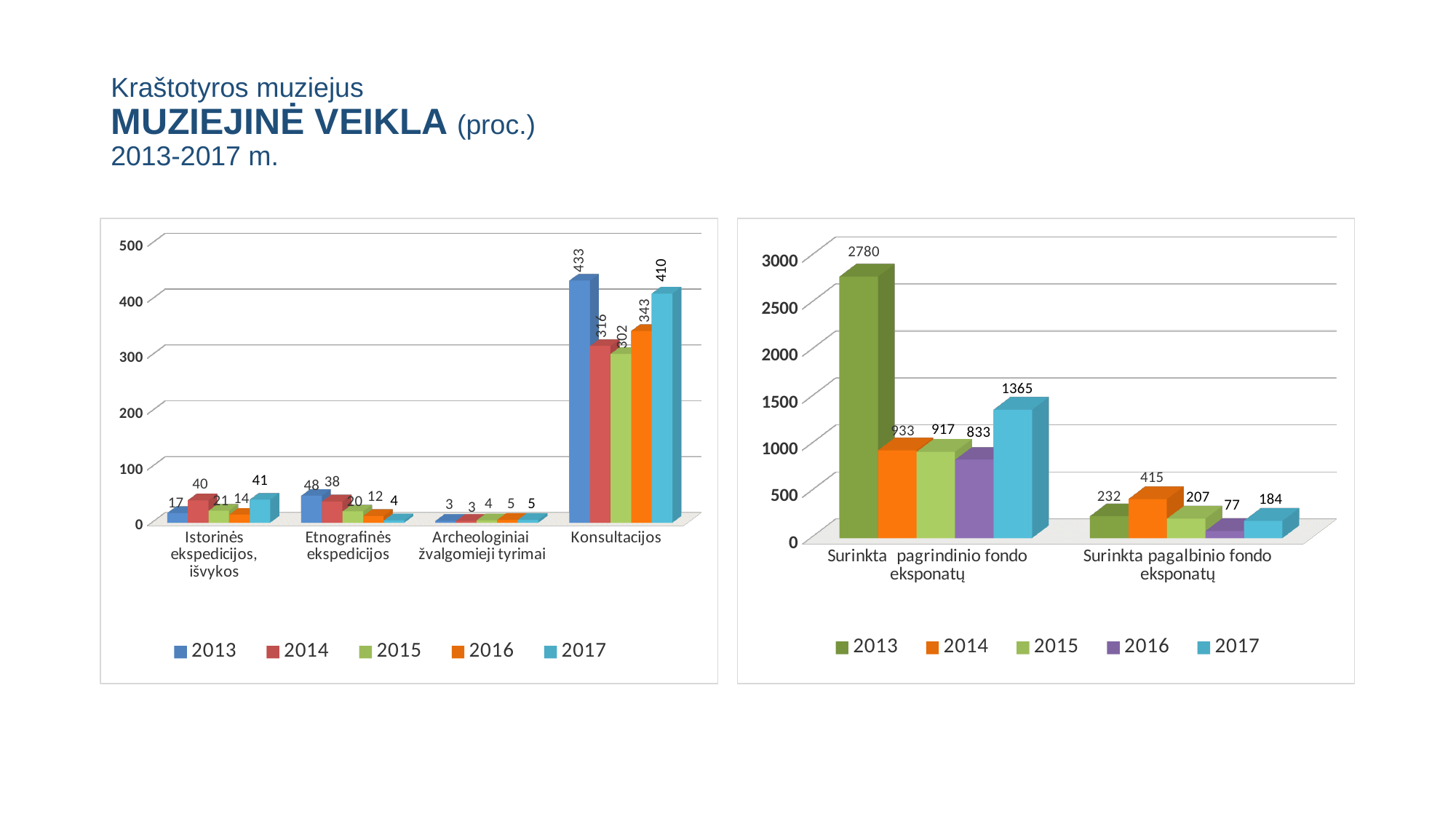
On the right chart, what is the difference between the 2017 and 2016 values for Surinkta pagrindinio fondo eksponatų? 532 On the left chart, what is the value for Konsultacijos in 2013? 433 On the left chart, how many categories are shown on the x axis? 4 On the left chart, what is the difference between the 2013 and 2014 values for Konsultacijos? 117 What kind of chart is the right chart? Bar chart How many series does the legend of the right chart list? 5 On the left chart, which year has the highest value for Istorinės ekspedicijos, išvykos? 2017 On the left chart, what is the value for Etnografinės ekspedicijos in 2017? 4 On the right chart, which year has the lowest value for Surinkta pagalbinio fondo eksponatų? 2016 On the left chart, is the 2017 value for Konsultacijos greater or less than 400? greater On the right chart, what is the value for Surinkta pagrindinio fondo eksponatų in 2013? 2780 On the right chart, which is larger for Surinkta pagalbinio fondo eksponatų: 2014 or 2017? 2014